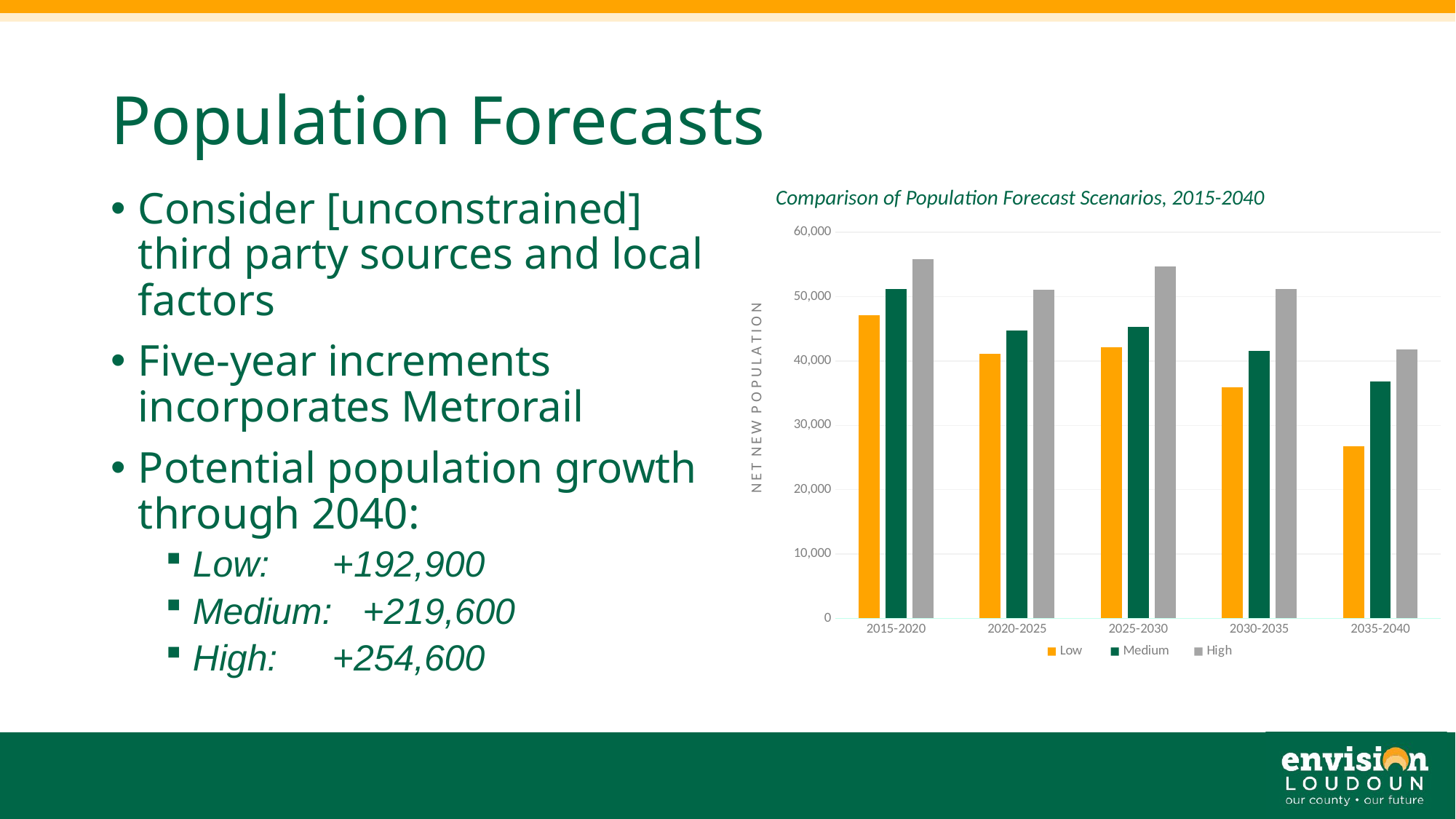
Is the Low value for 2030-2035 greater or less than 40,000? less How many time periods are shown on the x axis of the chart? 5 Is the High value for 2015-2020 greater or less than 50,000? greater In which period is the High series at its highest? 2015-2020 What kind of chart is shown on the slide? Bar chart How many series does the chart legend list? 3 What is the label on the vertical axis of the chart? NET NEW POPULATION Is the Low value for 2035-2040 greater or less than 30,000? less From 2025-2030 through 2035-2040, do the Medium bars rise or fall? fall What is the title of the chart? Comparison of Population Forecast Scenarios, 2015-2040 Which is larger, the Low value for 2015-2020 or the Low value for 2035-2040? 2015-2020 In which period is the Low series at its lowest? 2035-2040